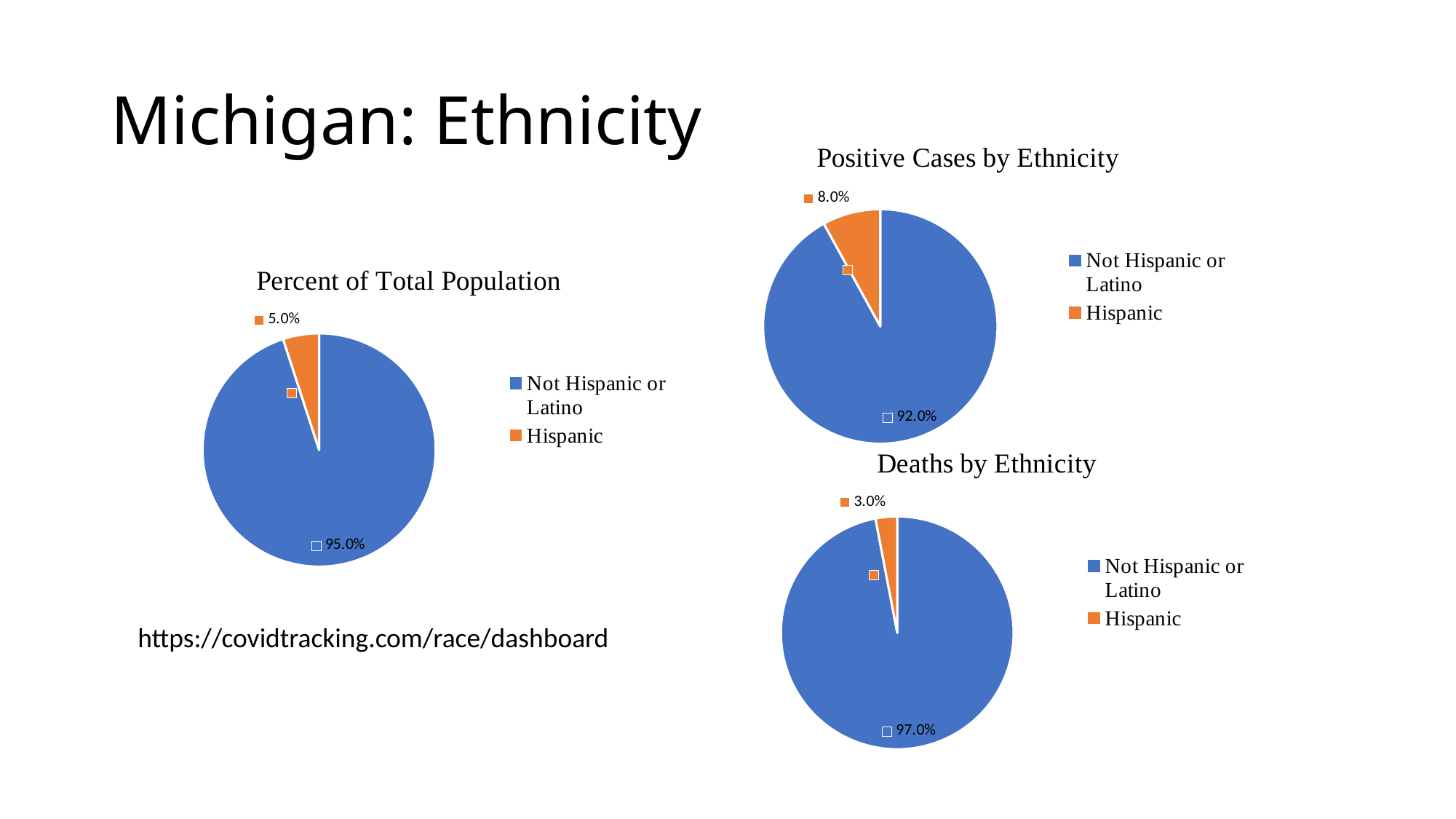
In the 'Deaths by Ethnicity' chart, what share of the pie is Hispanic? 3.0% In the 'Percent of Total Population' chart, what colour is the Hispanic slice? Orange In the 'Positive Cases by Ethnicity' chart, what share of the pie is Hispanic? 8.0% In the 'Deaths by Ethnicity' chart, which category has the smallest slice? Hispanic What type of chart is the 'Deaths by Ethnicity' chart? Pie chart In the 'Positive Cases by Ethnicity' chart, what is the difference between the Not Hispanic or Latino share and the Hispanic share? 84.0% In the 'Positive Cases by Ethnicity' chart, what share of the pie is Not Hispanic or Latino? 92.0% How many categories does the 'Percent of Total Population' chart show? 2 In the 'Positive Cases by Ethnicity' chart, which category has the largest slice? Not Hispanic or Latino